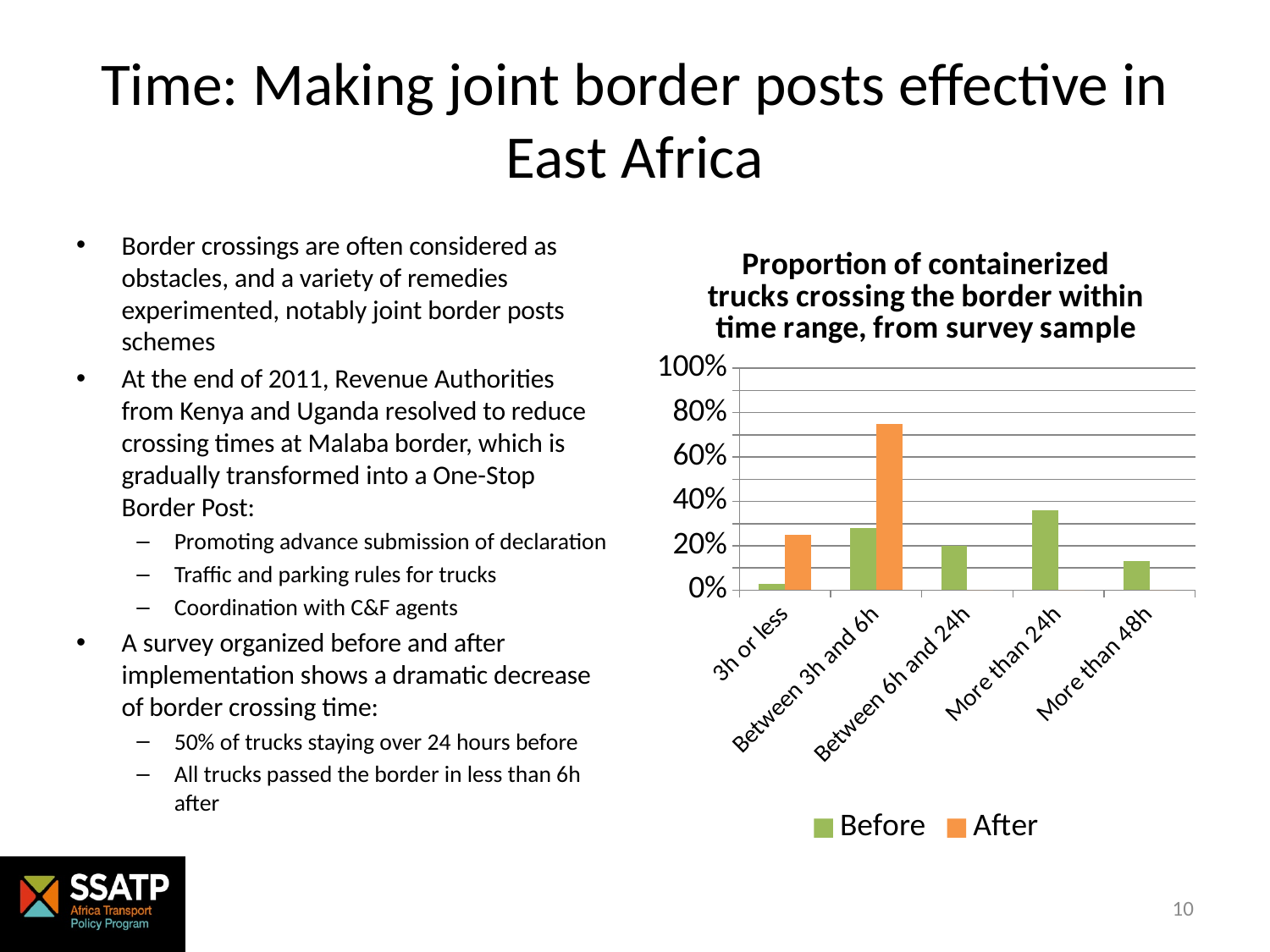
What kind of chart is shown on the slide? bar chart Is the Before value for More than 48h greater or less than 20%? less Is the After value for Between 3h and 6h greater or less than 60%? greater How many time-range categories are shown on the x axis of the chart? 5 Is the Before value for More than 24h greater or less than 20%? greater Which series is shown in orange in the chart? After For the 3h or less category, which is larger, the Before value or the After value? After How many series does the chart legend list? 2 What is the title of the chart? Proportion of containerized trucks crossing the border within time range, from survey sample Which category has the tallest bar in the chart? Between 3h and 6h Which category has the highest Before value? More than 24h Which category has the lowest Before value? 3h or less